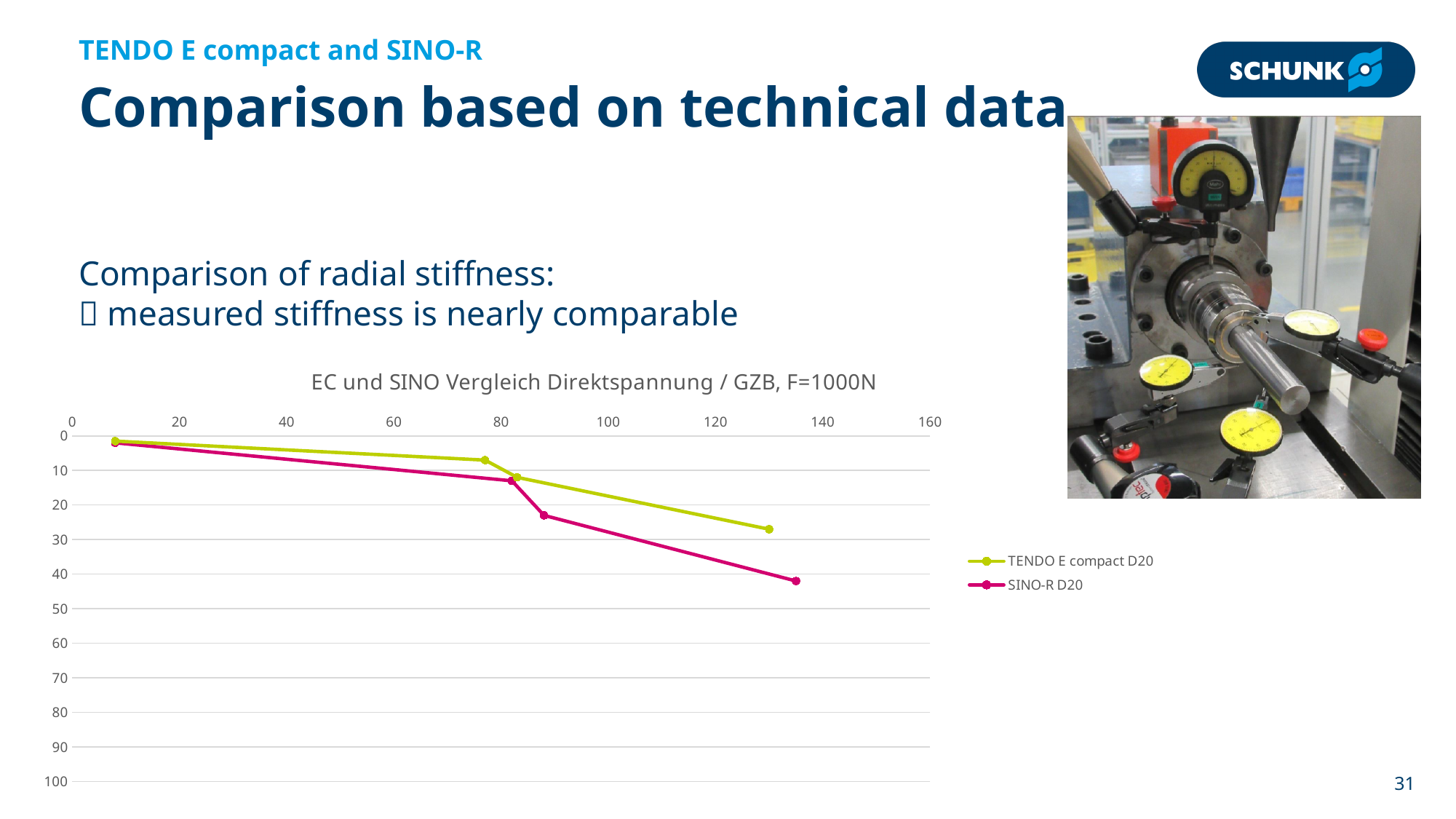
Is the vertical-axis value of the rightmost SINO-R D20 point greater or less than 30? greater How many series does the chart legend list? 2 How many data points are plotted for the TENDO E compact D20 series? 4 How many data points are plotted for the SINO-R D20 series? 4 What kind of chart is shown on the slide? line chart What is the title of the chart? EC und SINO Vergleich Direktspannung / GZB, F=1000N What are the names of the two series in the chart legend? TENDO E compact D20 and SINO-R D20 Reading the vertical axis (0 at the top, 100 at the bottom), do the plotted values for SINO-R D20 increase or decrease as the horizontal-axis value increases? increase Is the horizontal-axis value of the rightmost SINO-R D20 point greater or less than 120? greater Which series reaches the highest value on the vertical axis? SINO-R D20 At their rightmost data points, which series has the larger vertical-axis value, TENDO E compact D20 or SINO-R D20? SINO-R D20 Is the vertical-axis value of the rightmost TENDO E compact D20 point greater or less than 30? less